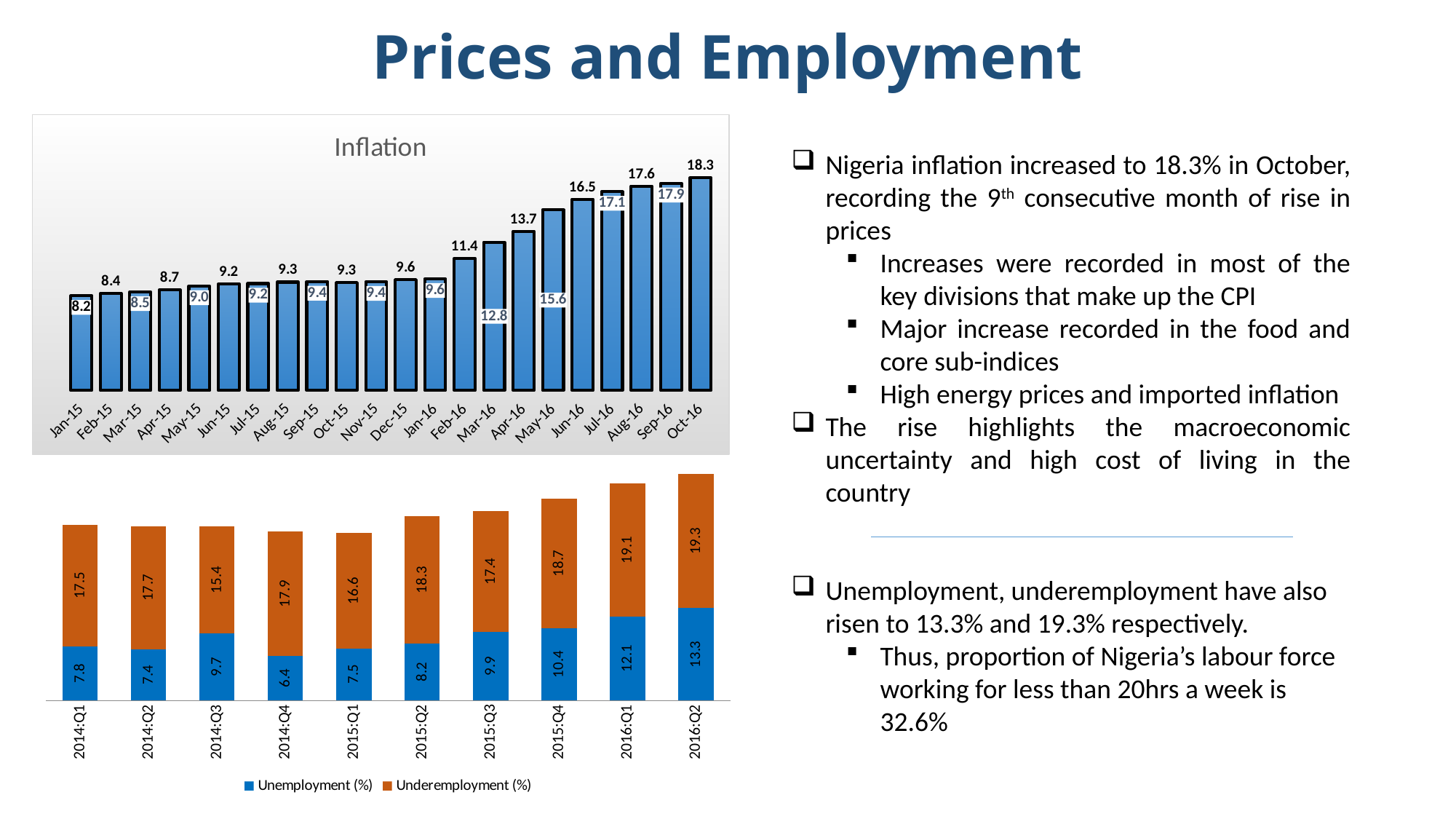
In the Inflation chart, what is the value for Oct-16? 18.3 In the bottom chart, what is the Underemployment (%) value for 2014:Q3? 15.4 In the Inflation chart, do the values generally rise or fall from Jan-15 to Oct-16? rise In the bottom chart, how many series does the legend list? 2 In the Inflation chart, what is the value for Mar-16? 12.8 In the bottom chart, which quarter has the lowest Unemployment (%) value? 2014:Q4 In the bottom chart, what is the Unemployment (%) value for 2016:Q2? 13.3 In the Inflation chart, how many months are plotted? 22 What kind of chart is the bottom chart? stacked bar chart In the Inflation chart, what is the difference between the values for Oct-16 and Jan-15? 10.1 In the bottom chart, what is the total of the stacked bar for 2016:Q2? 32.6 In the Inflation chart, which month has the lowest value? Jan-15